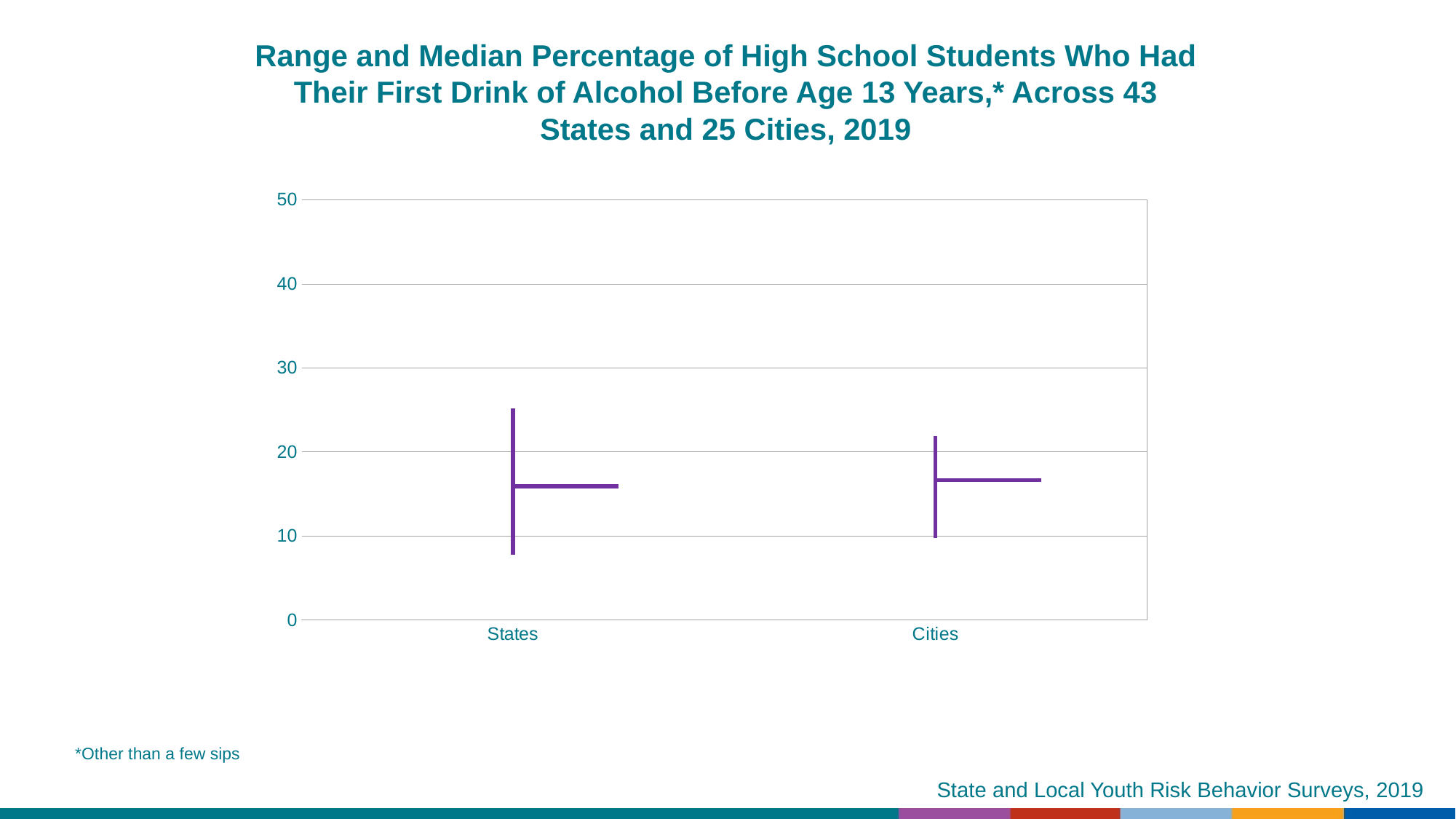
Which category shows the wider range of values? States Is the top of the range for States greater or less than 20? greater Is the median for Cities greater or less than 10? greater Is the median for States greater or less than 20? less How many categories are shown on the x axis of the chart? 2 What are the two categories shown on the x axis? States and Cities Which category has the lower bottom of its range, States or Cities? States What is the highest value shown on the y axis of the chart? 50 Which category has the higher top of its range, States or Cities? States